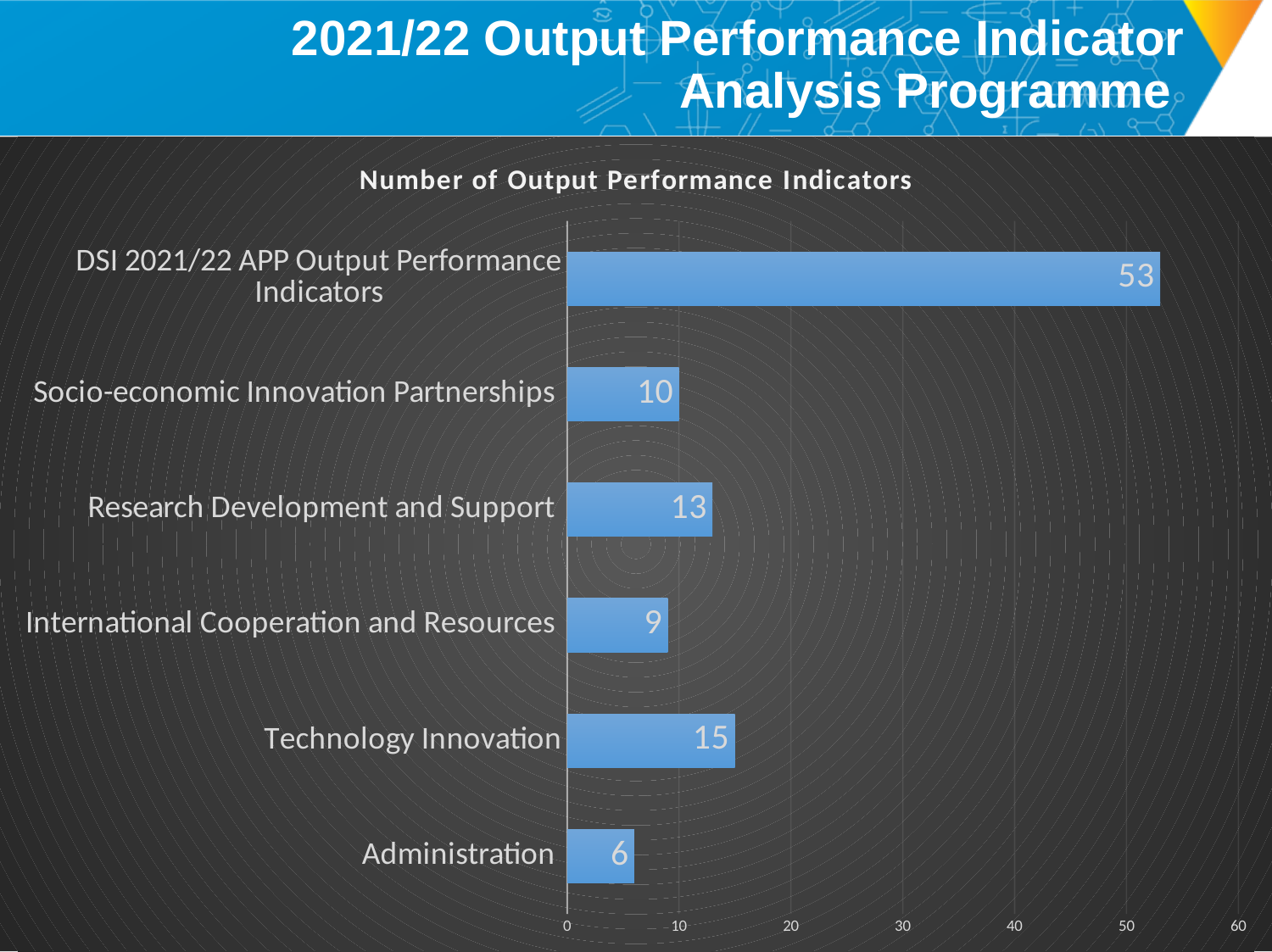
What kind of chart is shown on the slide? bar chart How many categories are shown in the chart? 6 What is the difference between the values for Technology Innovation and Administration? 9 Which category has the lowest value? Administration What is the value for Research Development and Support? 13 What is the value for International Cooperation and Resources? 9 Which is larger, the value for Socio-economic Innovation Partnerships or the value for Research Development and Support? Research Development and Support What is the title of the chart? Number of Output Performance Indicators Is the value for DSI 2021/22 APP Output Performance Indicators greater or less than 50? greater What is the value for Administration? 6 What is the value for Technology Innovation? 15 Which category has the highest value? DSI 2021/22 APP Output Performance Indicators